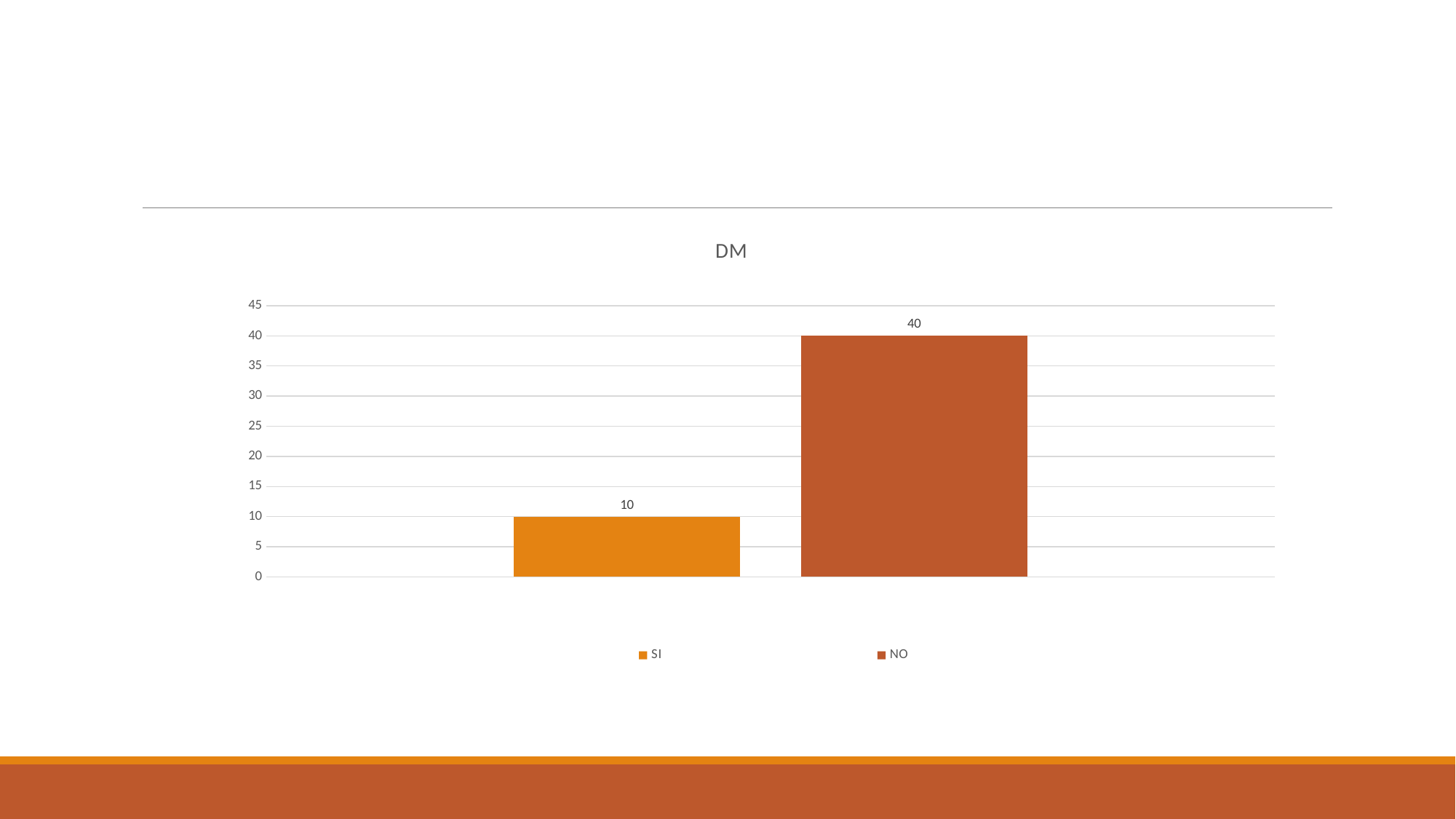
Which category has the highest value in the DM chart? NO What is the value for SI in the DM chart? 10 What kind of chart is shown on the slide? Bar chart What is the value for NO in the DM chart? 40 Is the value for NO greater or less than 35? greater What is the title of the chart on the slide? DM Is the value for SI greater or less than 15? less How many bars are plotted in the DM chart? 2 Which is larger in the DM chart, SI or NO? NO What is the difference between the values for NO and SI in the DM chart? 30 How many entries does the legend of the DM chart list? 2 Which category has the lowest value in the DM chart? SI